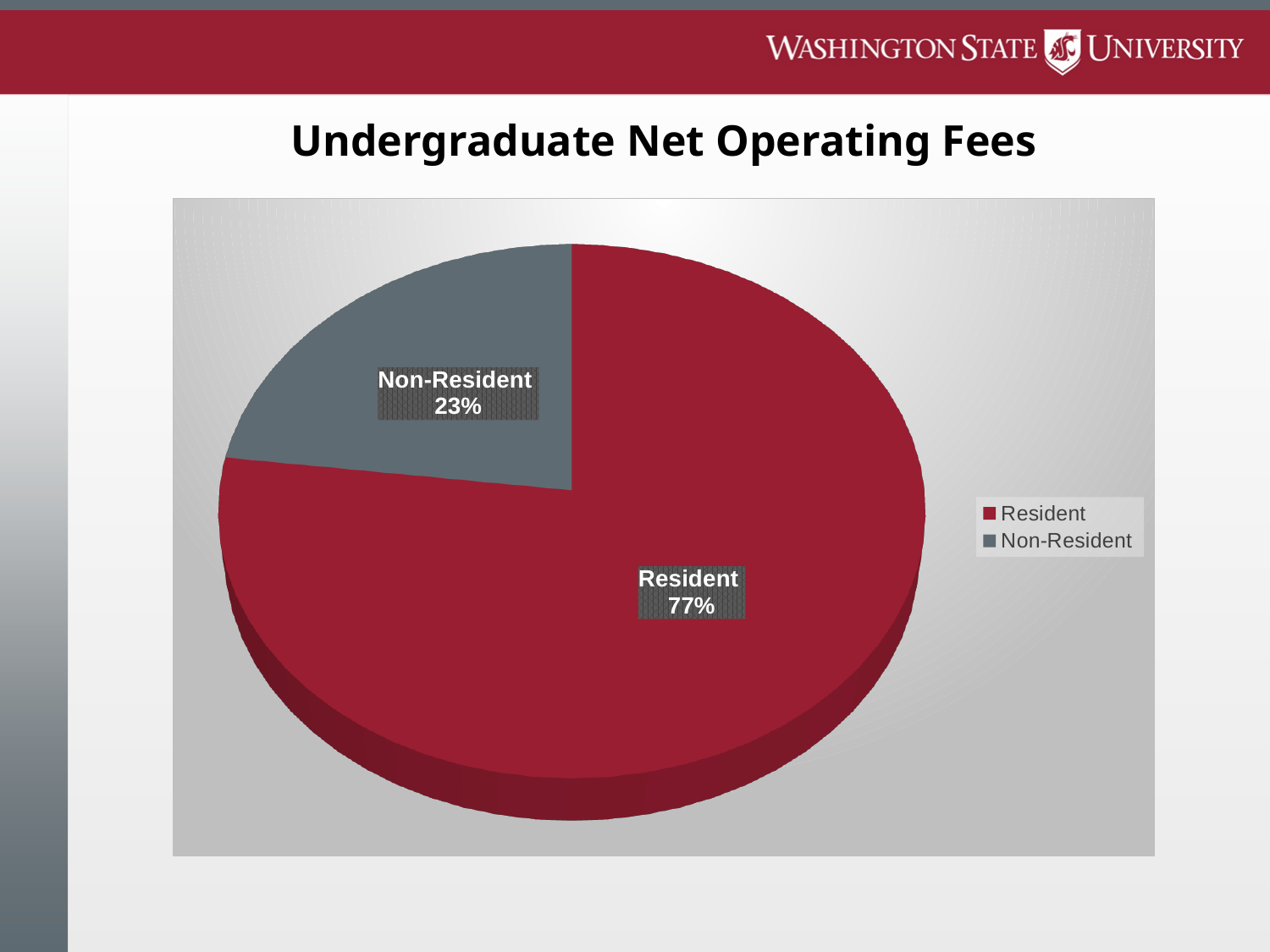
What kind of chart is shown on the slide? Pie chart Which category has the smallest slice of the pie? Non-Resident How many categories are shown in the pie chart? 2 What colour is the Non-Resident slice? Grey What is the difference in percentage points between the Resident and Non-Resident shares? 54 What share of Undergraduate Net Operating Fees comes from Resident students? 77% What share of Undergraduate Net Operating Fees comes from Non-Resident students? 23% Which category has the largest slice of the pie? Resident What is the title of the chart? Undergraduate Net Operating Fees Which is larger, the Resident share or the Non-Resident share? Resident How many entries does the legend list? 2